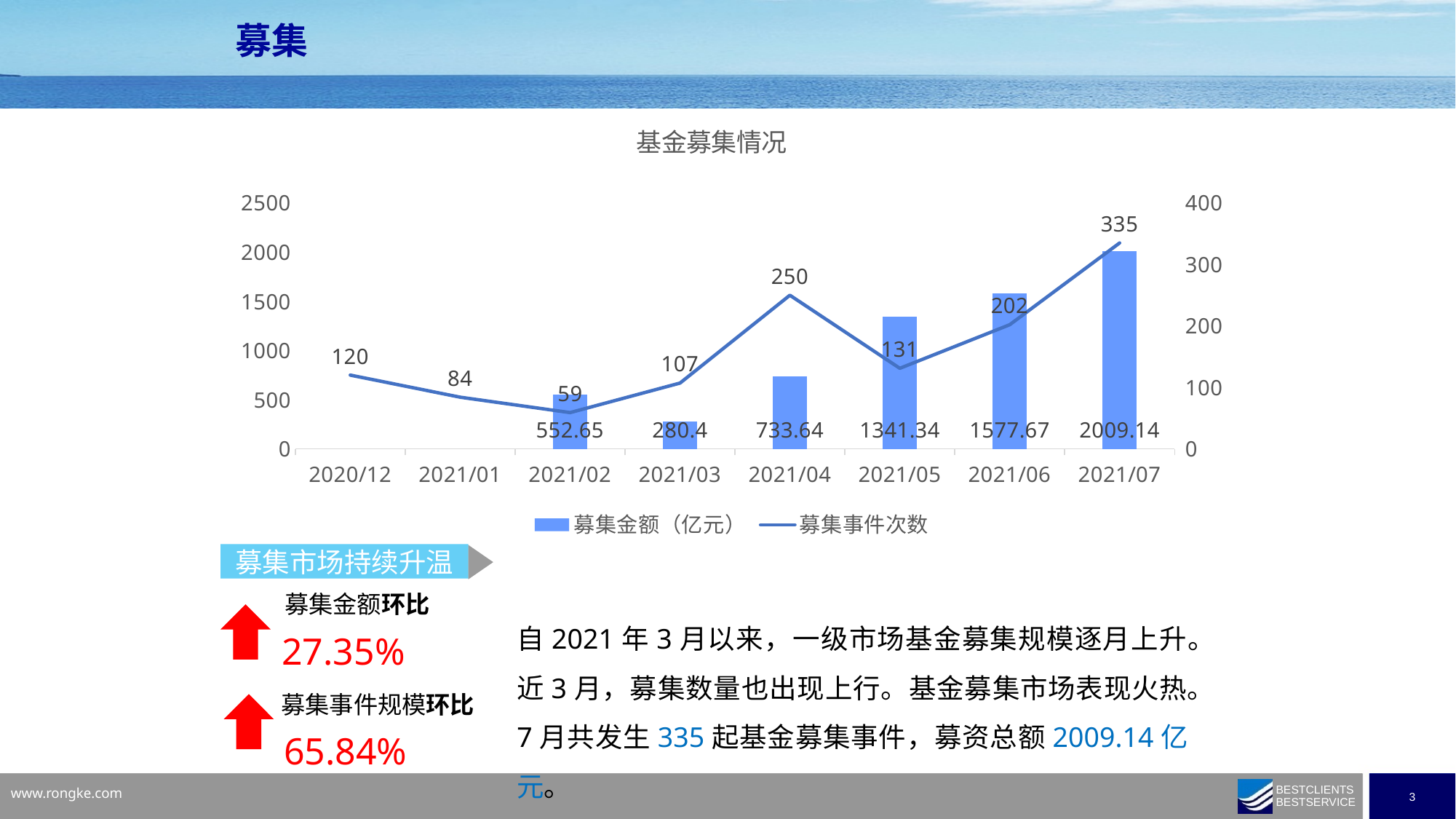
Which month has the lowest 募集事件次数? 2021/02 How many series does the legend list? 2 What is the title of the chart? 基金募集情况 Which is larger, the 募集事件次数 for 2021/05 or for 2021/06? 2021/06 Do the 募集金额（亿元） bars rise or fall from 2021/03 to 2021/07? rise What is the 募集金额（亿元） value for 2021/07? 2009.14 What is the difference in 募集金额（亿元） between 2021/07 and 2021/06? 431.47 What is the 募集金额（亿元） value for 2021/03? 280.4 What is the 募集事件次数 value for 2021/04? 250 Which month has the highest 募集事件次数? 2021/07 How many categories are shown on the x axis? 8 Which month has the lowest labelled 募集金额（亿元） bar? 2021/03